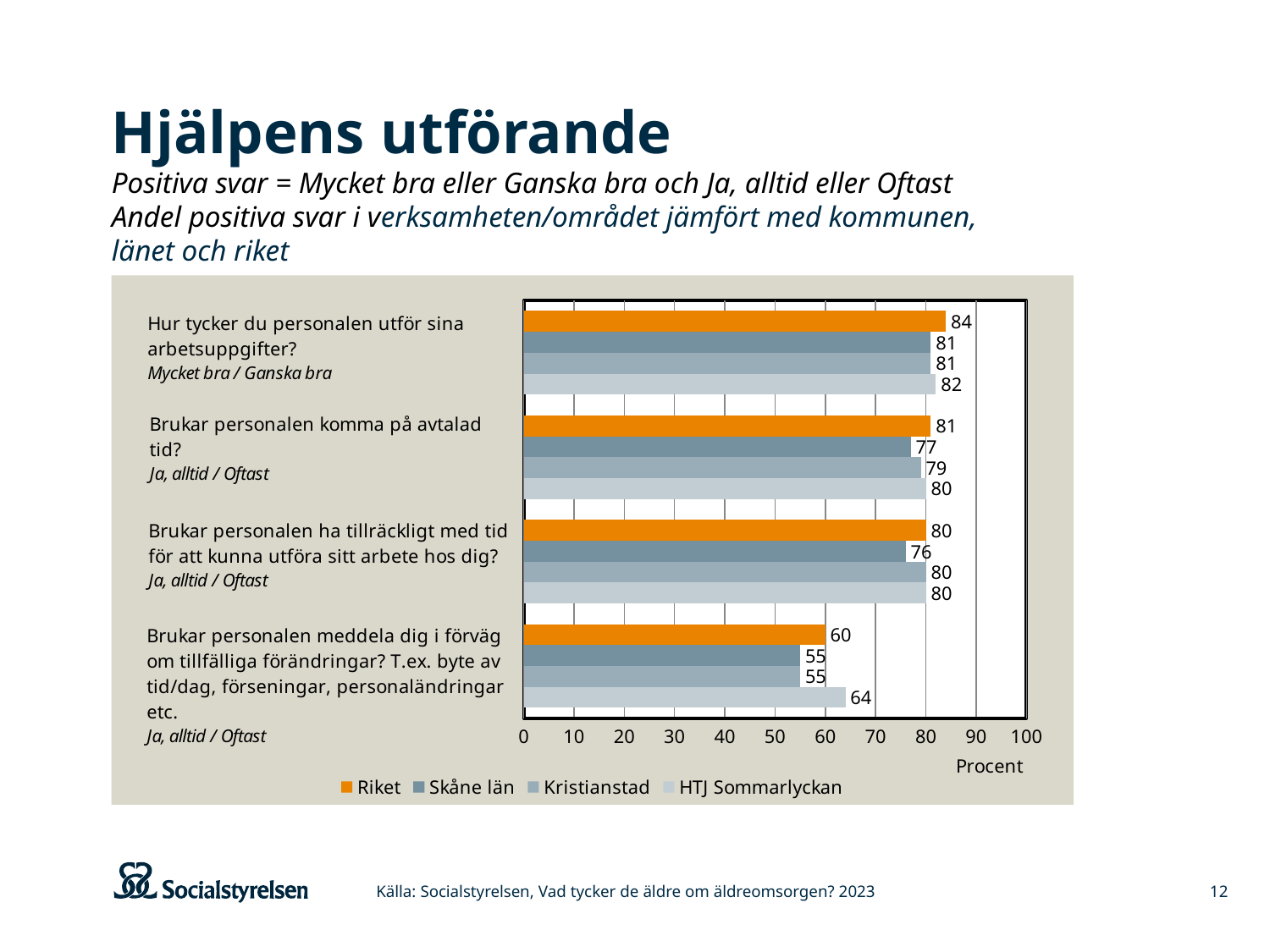
Which is larger for the question "Brukar personalen komma på avtalad tid?": Riket or Kristianstad? Riket How many series does the legend list? 4 Which series has the highest value for the question "Brukar personalen meddela dig i förväg om tillfälliga förändringar?"? HTJ Sommarlyckan What is the value for HTJ Sommarlyckan for the question "Brukar personalen meddela dig i förväg om tillfälliga förändringar?"? 64 What is the difference between HTJ Sommarlyckan and Riket for the question "Hur tycker du personalen utför sina arbetsuppgifter?"? 2 What is the label of the x axis? Procent For which question does HTJ Sommarlyckan have its lowest value? Brukar personalen meddela dig i förväg om tillfälliga förändringar? What is the value for Skåne län for the question "Brukar personalen komma på avtalad tid?"? 77 What is the value for Riket for the question "Hur tycker du personalen utför sina arbetsuppgifter?"? 84 What kind of chart is shown on the slide? Bar chart What is the difference between Riket and Skåne län for the question "Brukar personalen meddela dig i förväg om tillfälliga förändringar?"? 5 What is the value for Kristianstad for the question "Brukar personalen ha tillräckligt med tid för att kunna utföra sitt arbete hos dig?"? 80